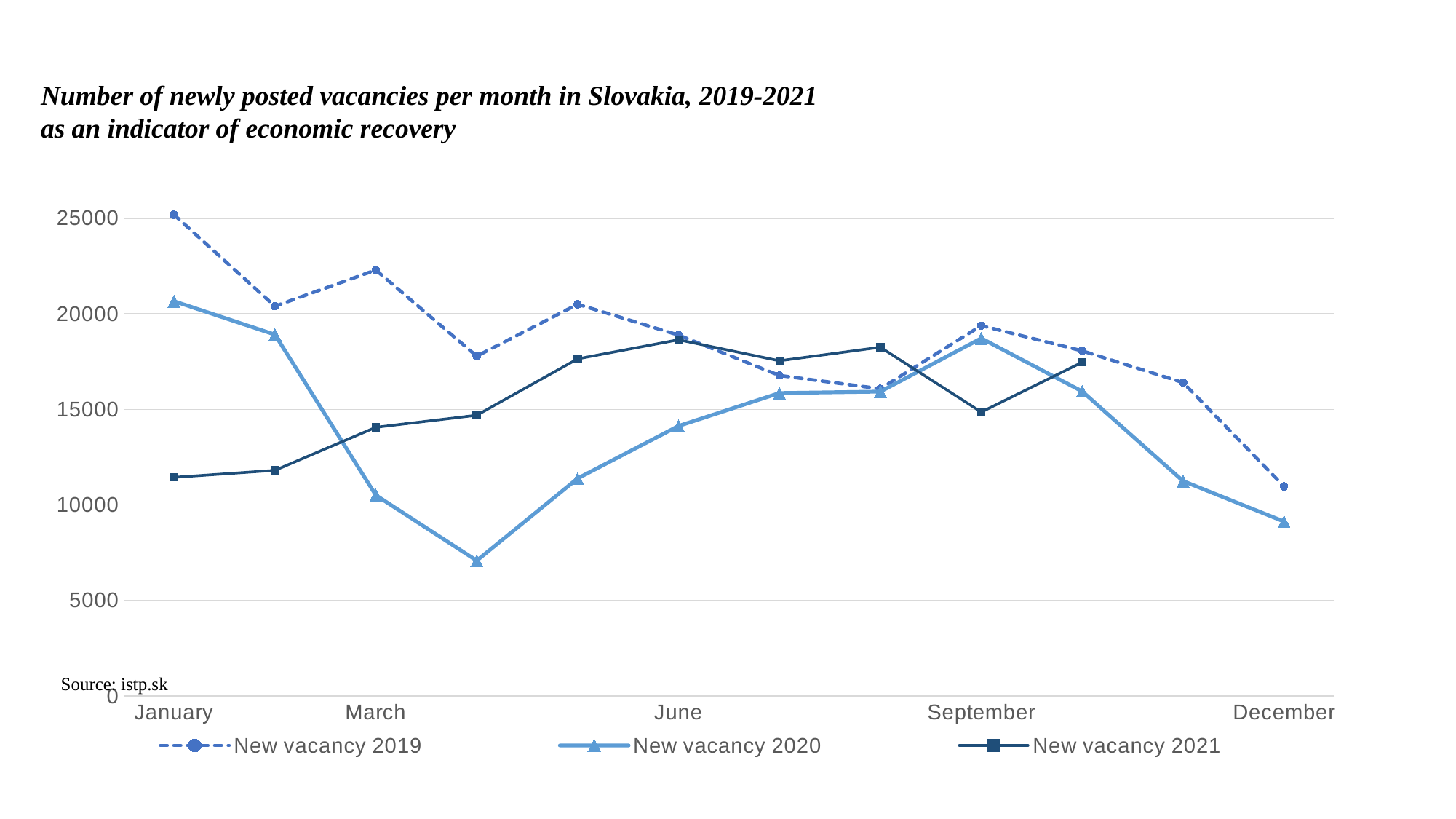
Does the value for New vacancy 2020 rise or fall from March to September? rise Is the value for New vacancy 2020 in December greater or less than 10000? less What kind of chart is shown on the slide? line chart Is the value for New vacancy 2020 in March greater or less than 15000? less Which is larger in September, New vacancy 2020 or New vacancy 2021? New vacancy 2020 In which month is the value for New vacancy 2019 highest? January In which month is the value for New vacancy 2020 highest? January In which month is the value for New vacancy 2019 lowest? December Which series is drawn with a dashed line? New vacancy 2019 Is the value for New vacancy 2019 in March greater or less than 20000? greater How many series does the legend list? 3 Which is larger in March, New vacancy 2020 or New vacancy 2021? New vacancy 2021